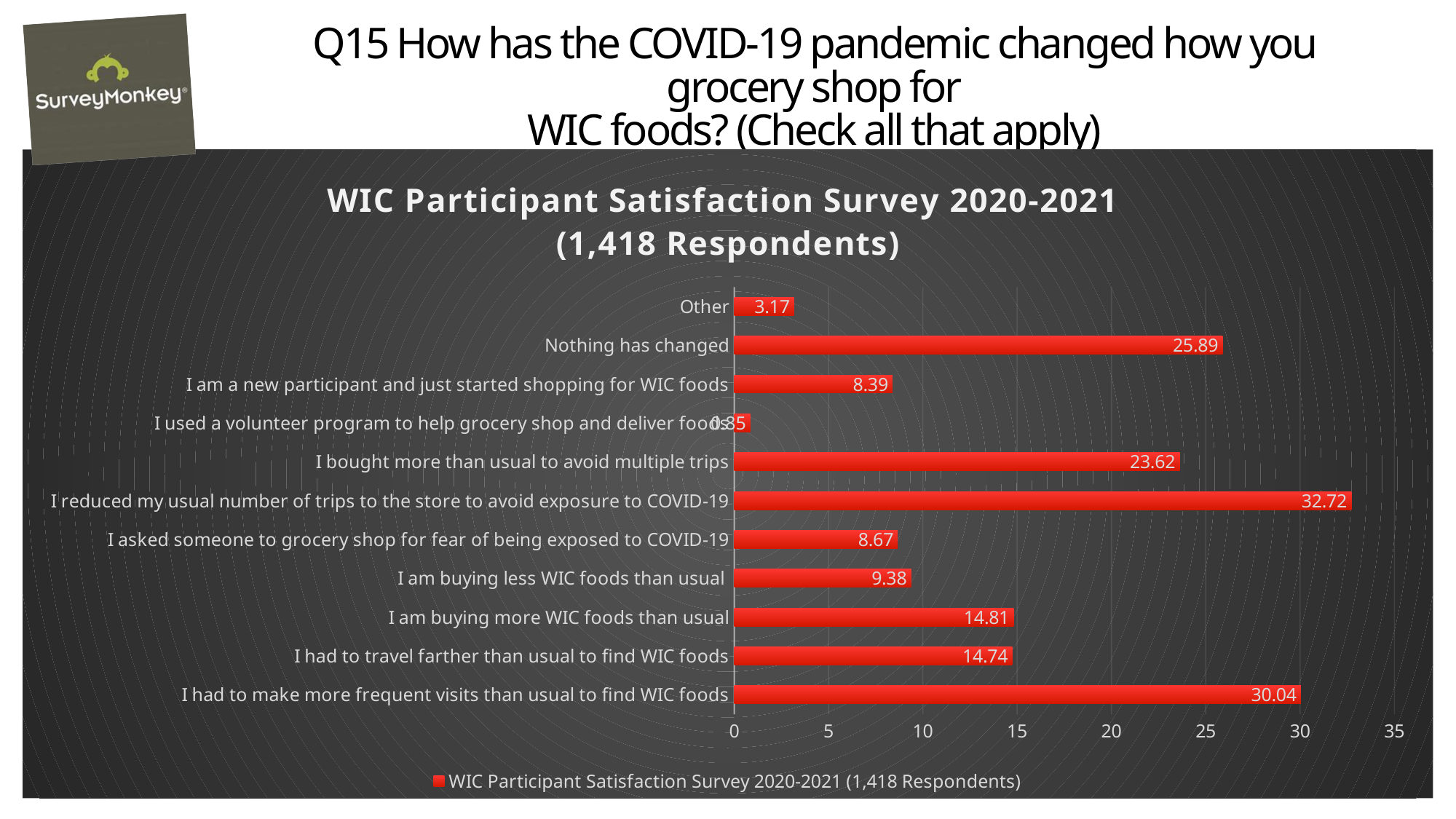
What kind of chart is shown on the slide? bar chart What is the value for "I reduced my usual number of trips to the store to avoid exposure to COVID-19"? 32.72 How many categories are shown in the chart? 11 What is the value for "Other"? 3.17 Which is larger: the value for "Nothing has changed" or the value for "I bought more than usual to avoid multiple trips"? Nothing has changed Is the value for "I bought more than usual to avoid multiple trips" greater or less than 20? greater Which category has the lowest value? I used a volunteer program to help grocery shop and deliver foods What is the value for "I had to make more frequent visits than usual to find WIC foods"? 30.04 What is the value for "Nothing has changed"? 25.89 Which category has the highest value? I reduced my usual number of trips to the store to avoid exposure to COVID-19 How many series does the legend list? 1 What is the difference between the values for "I reduced my usual number of trips to the store to avoid exposure to COVID-19" and "I had to make more frequent visits than usual to find WIC foods"? 2.68